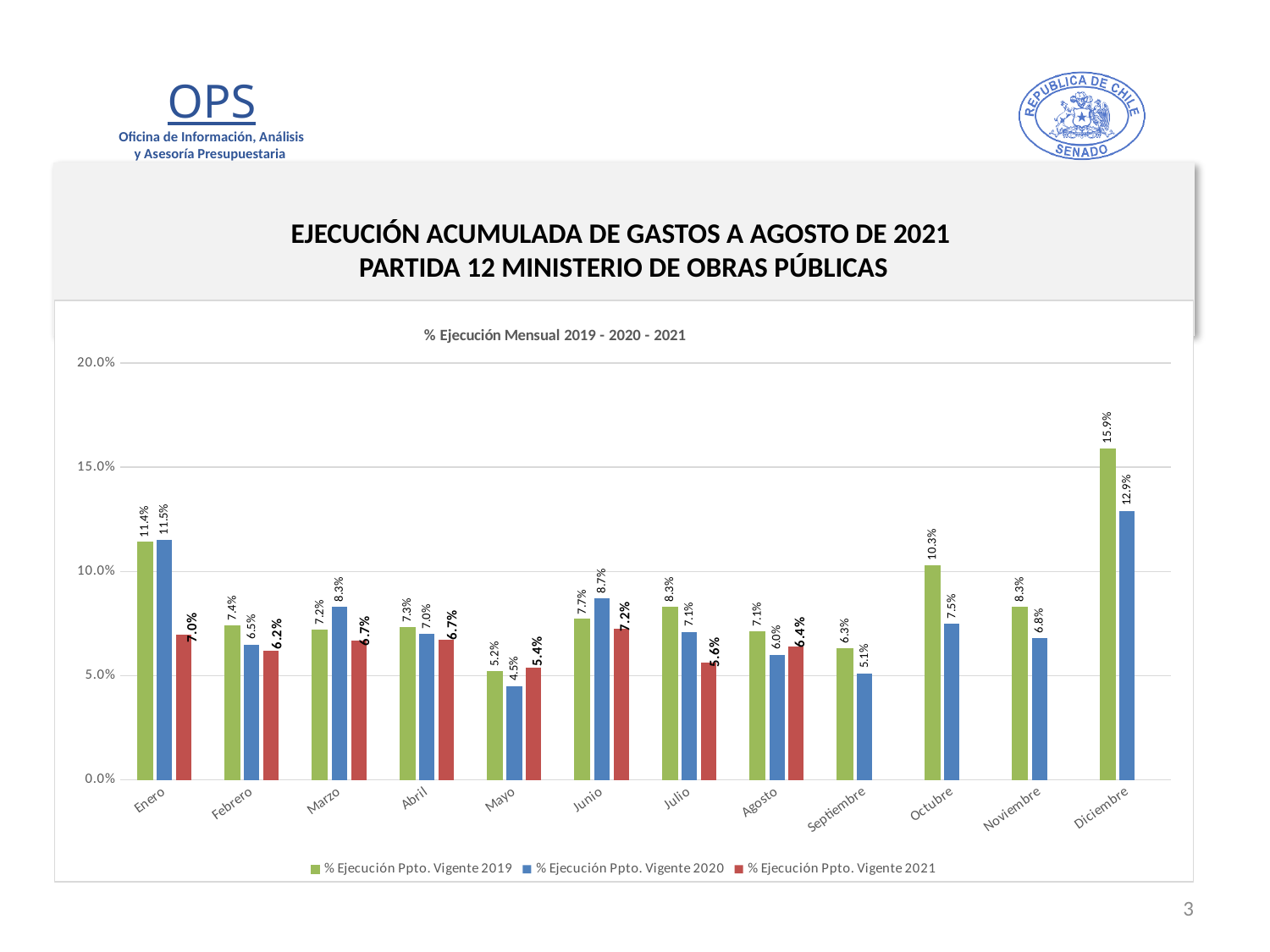
Is the value for % Ejecución Ppto. Vigente 2019 in Octubre greater or less than 10.0%? greater What is the difference between the 2019 and 2020 values in Diciembre? 3.0% Which month has the lowest value for % Ejecución Ppto. Vigente 2019? Mayo In Julio, which is larger: the 2019 value or the 2021 value? 2019 value Which month has the highest value for % Ejecución Ppto. Vigente 2020? Diciembre What is the value for % Ejecución Ppto. Vigente 2019 in Diciembre? 15.9% What kind of chart is shown on the slide? Bar chart How many series does the legend list? 3 What is the value for % Ejecución Ppto. Vigente 2020 in Junio? 8.7% What is the value for % Ejecución Ppto. Vigente 2021 in Enero? 7.0% How many months are shown on the x axis? 12 What is the title of the chart? % Ejecución Mensual 2019 - 2020 - 2021